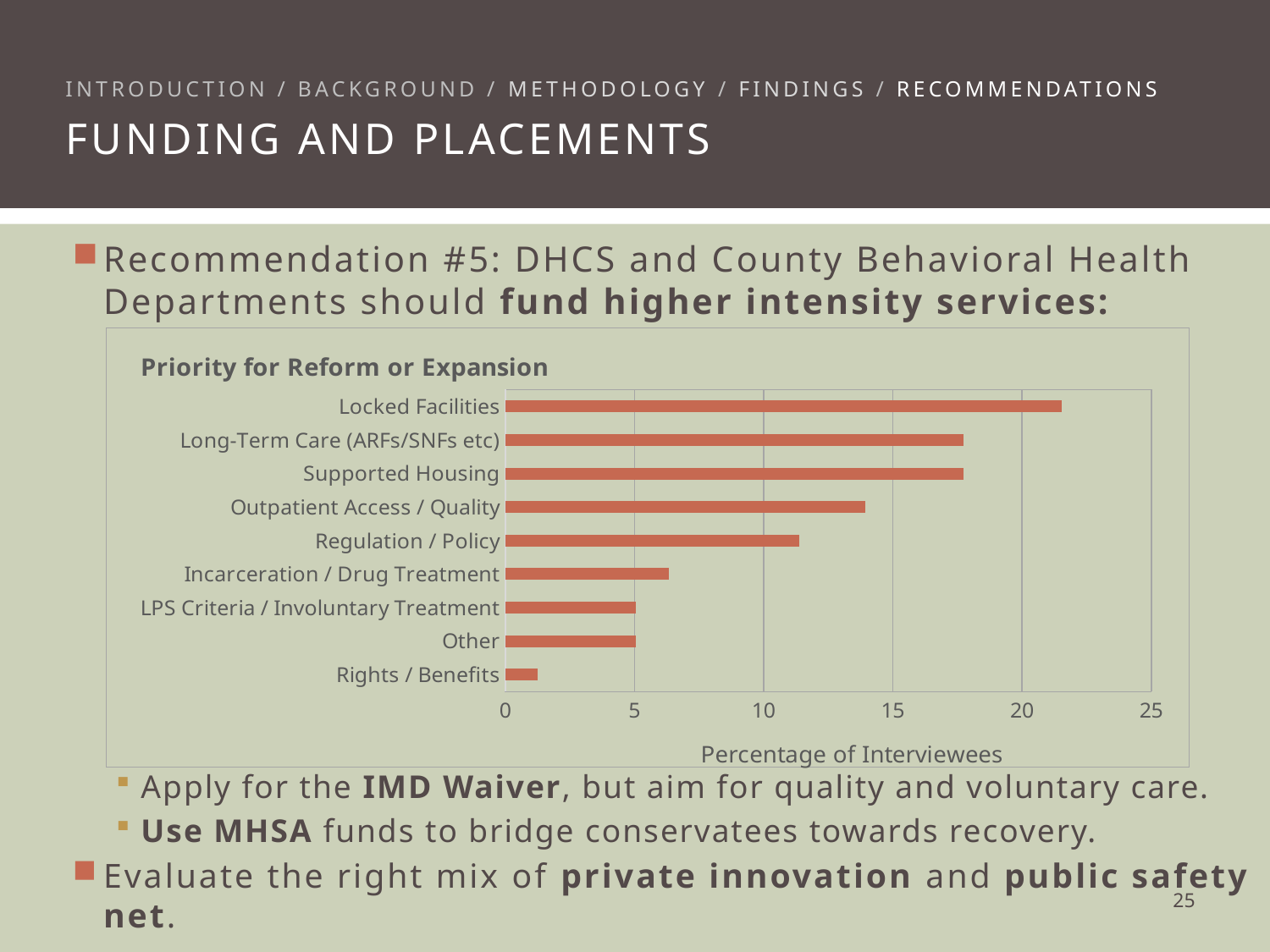
Is the value for Rights / Benefits greater or less than 5? less Is the value for Regulation / Policy greater or less than 10? greater How many categories are plotted in the chart? 9 Which has a larger value, Outpatient Access / Quality or Regulation / Policy? Outpatient Access / Quality Is the value for Outpatient Access / Quality greater or less than 15? less Which category has the lowest value in the chart? Rights / Benefits Which has a larger value, Incarceration / Drug Treatment or Supported Housing? Supported Housing What is the title of the chart? Priority for Reform or Expansion What kind of chart is shown on the slide? bar chart Which category has the highest value in the chart? Locked Facilities What is the label of the horizontal axis of the chart? Percentage of Interviewees